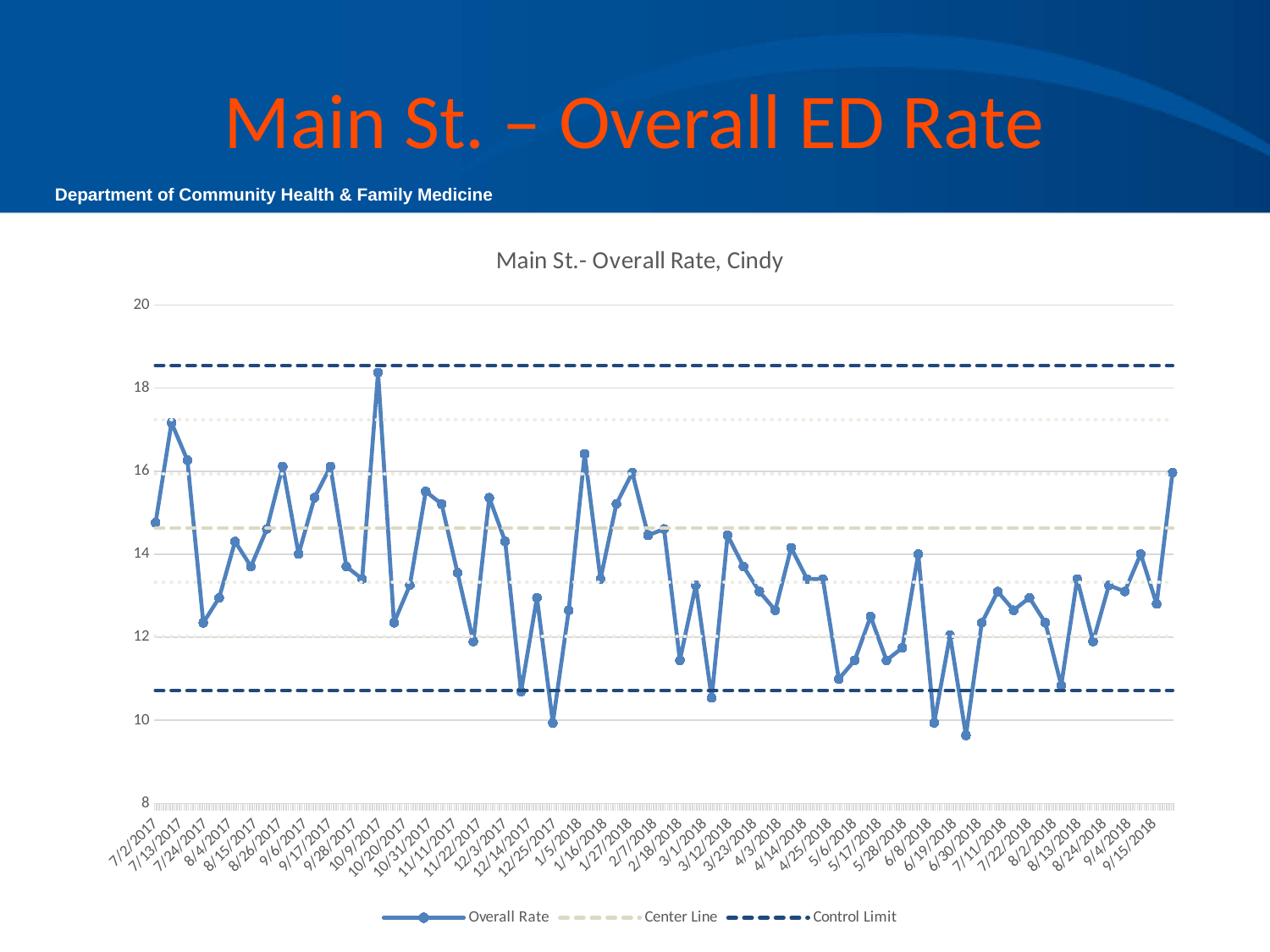
Is the Overall Rate value for 10/9/2017 greater or less than 18? greater Is the Overall Rate value for 7/2/2017 greater or less than 14? greater What is the title of the chart? Main St.- Overall Rate, Cindy Is the Overall Rate value for 2/18/2018 greater or less than 12? less Which has the larger Overall Rate, 10/9/2017 or 7/13/2017? 10/9/2017 What kind of chart is shown on the slide? line chart Which has the larger Overall Rate, 7/2/2017 or 7/24/2017? 7/2/2017 On which date does the Overall Rate reach its highest value? 10/9/2017 How many series does the legend list? 3 Which legend entry is drawn as a dark blue dashed line? Control Limit